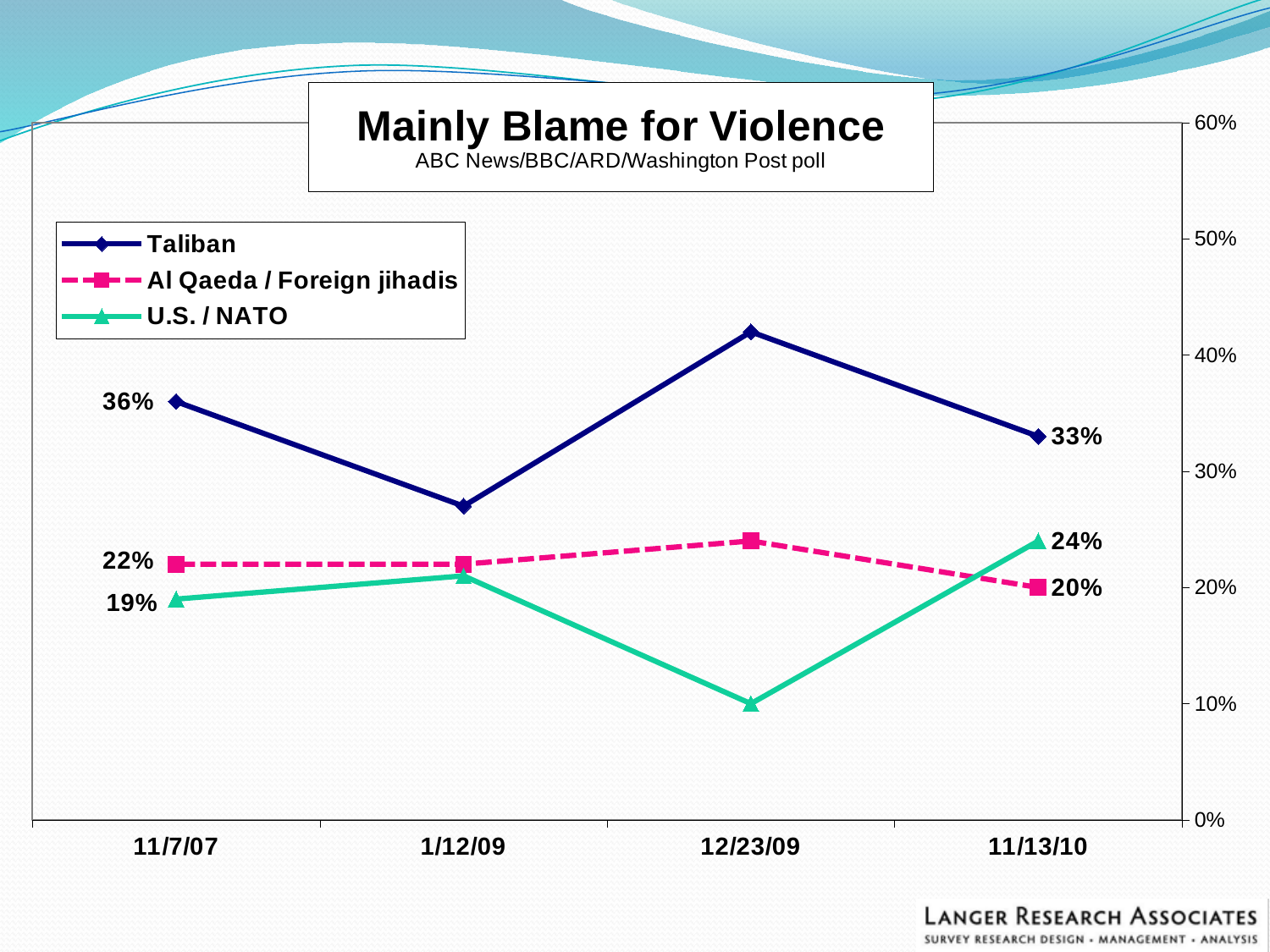
What is the value for Taliban on 11/7/07? 36% By how many percentage points did the Taliban value change from 11/7/07 to 11/13/10? 3 percentage points On 11/13/10, which is larger: the value for U.S. / NATO or the value for Al Qaeda / Foreign jihadis? U.S. / NATO What is the title of the chart? Mainly Blame for Violence How many dates are shown on the x axis? 4 What is the value for U.S. / NATO on 11/13/10? 24% How many series does the legend list? 3 What is the value for Al Qaeda / Foreign jihadis on 11/13/10? 20% What is the value for U.S. / NATO on 11/7/07? 19% What kind of chart is shown on the slide? line chart On which date does the Taliban series reach its highest value? 12/23/09 Is the value for Taliban on 12/23/09 greater or less than 40%? greater